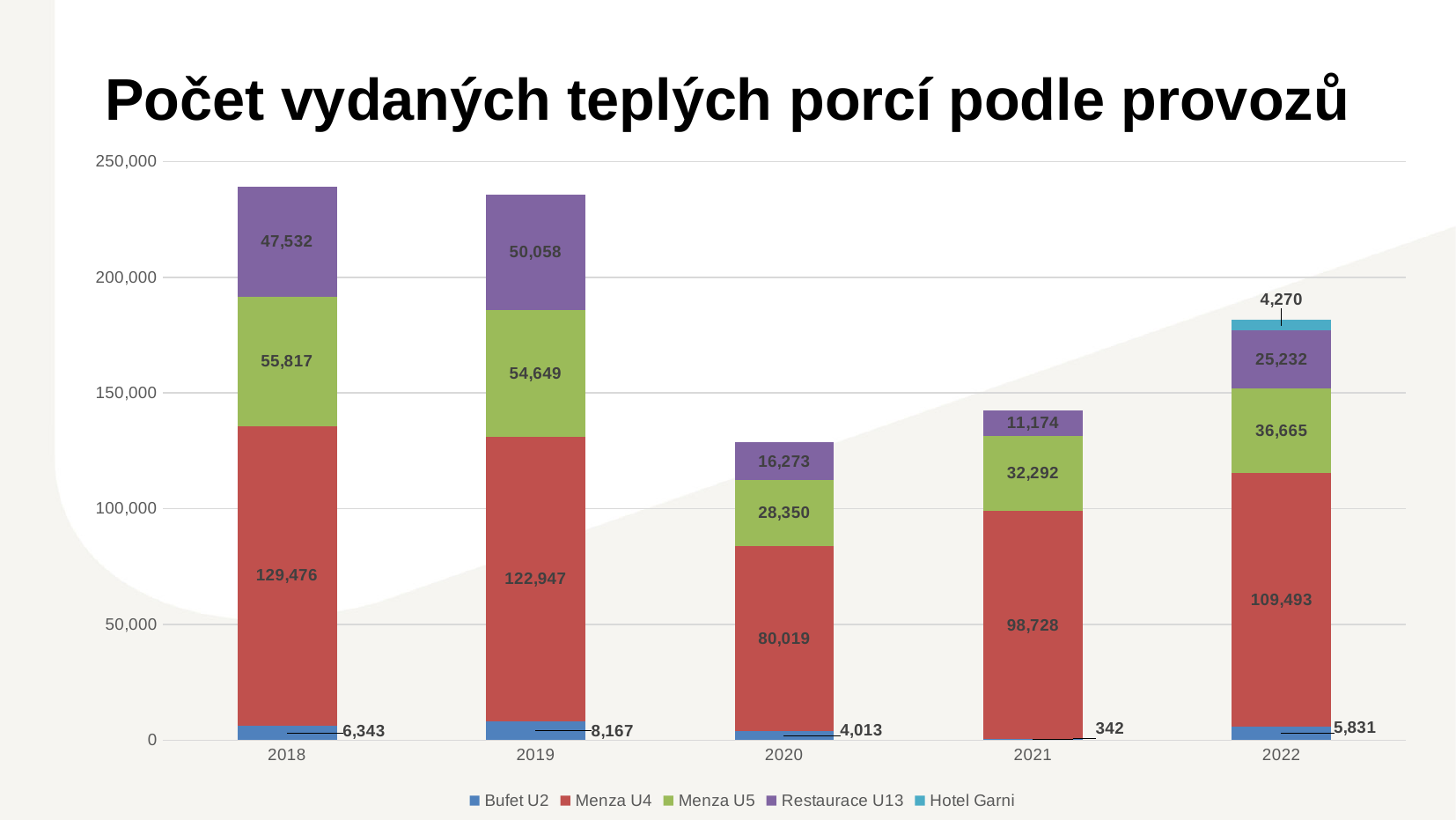
What type of chart is shown on the slide? stacked bar chart What is the value for Bufet U2 in 2021? 342 How many series does the legend list? 5 What is the value for Hotel Garni in 2022? 4,270 In which year is the Menza U4 value the lowest? 2020 In which year is the Restaurace U13 value the highest? 2019 Which is larger, the Menza U4 value in 2021 or in 2022? 2022 What is the value for Restaurace U13 in 2019? 50,058 How many years are shown on the x axis? 5 What is the value for Menza U4 in 2018? 129,476 What is the difference between the Menza U5 values in 2018 and 2019? 1,168 What is the total of the stacked bar for 2020? 128,655